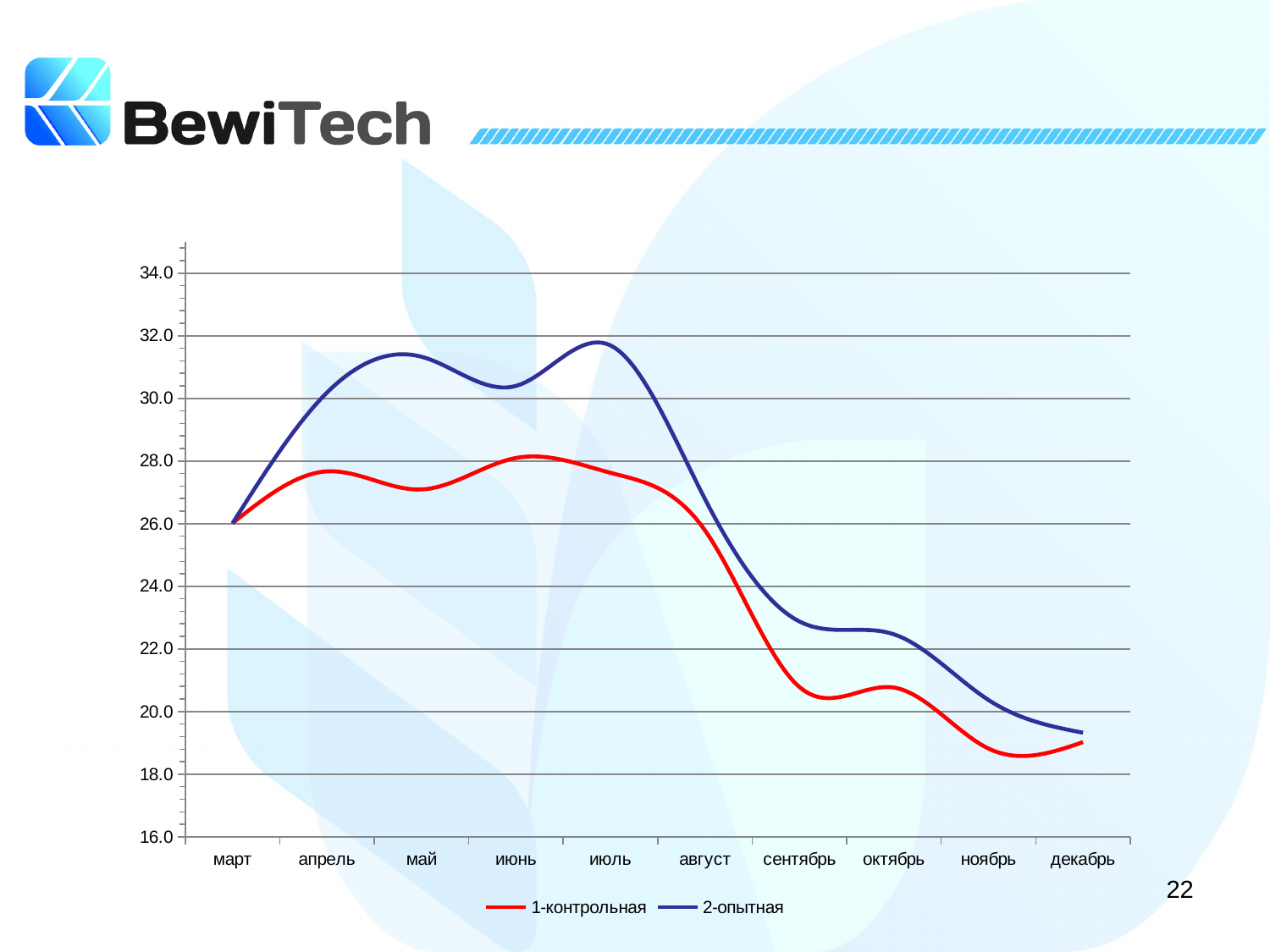
Is the value for 1-контрольная in сентябрь greater or less than 22.0? less Is the value for 2-опытная in декабрь greater or less than 20.0? less How many months are shown on the x axis? 10 Is the value for 2-опытная in июль greater or less than 30.0? greater Which series has the larger value in май, 1-контрольная or 2-опытная? 2-опытная How many series does the legend list? 2 What is the value for 2-опытная in март? 26.0 Do the values of the 2-опытная series rise or fall from июль to декабрь? fall In which month does the 1-контрольная series reach its lowest value? ноябрь What kind of chart is shown on the slide? line chart Which colour is used for the 1-контрольная series? red In which month does the 2-опытная series reach its highest value? июль